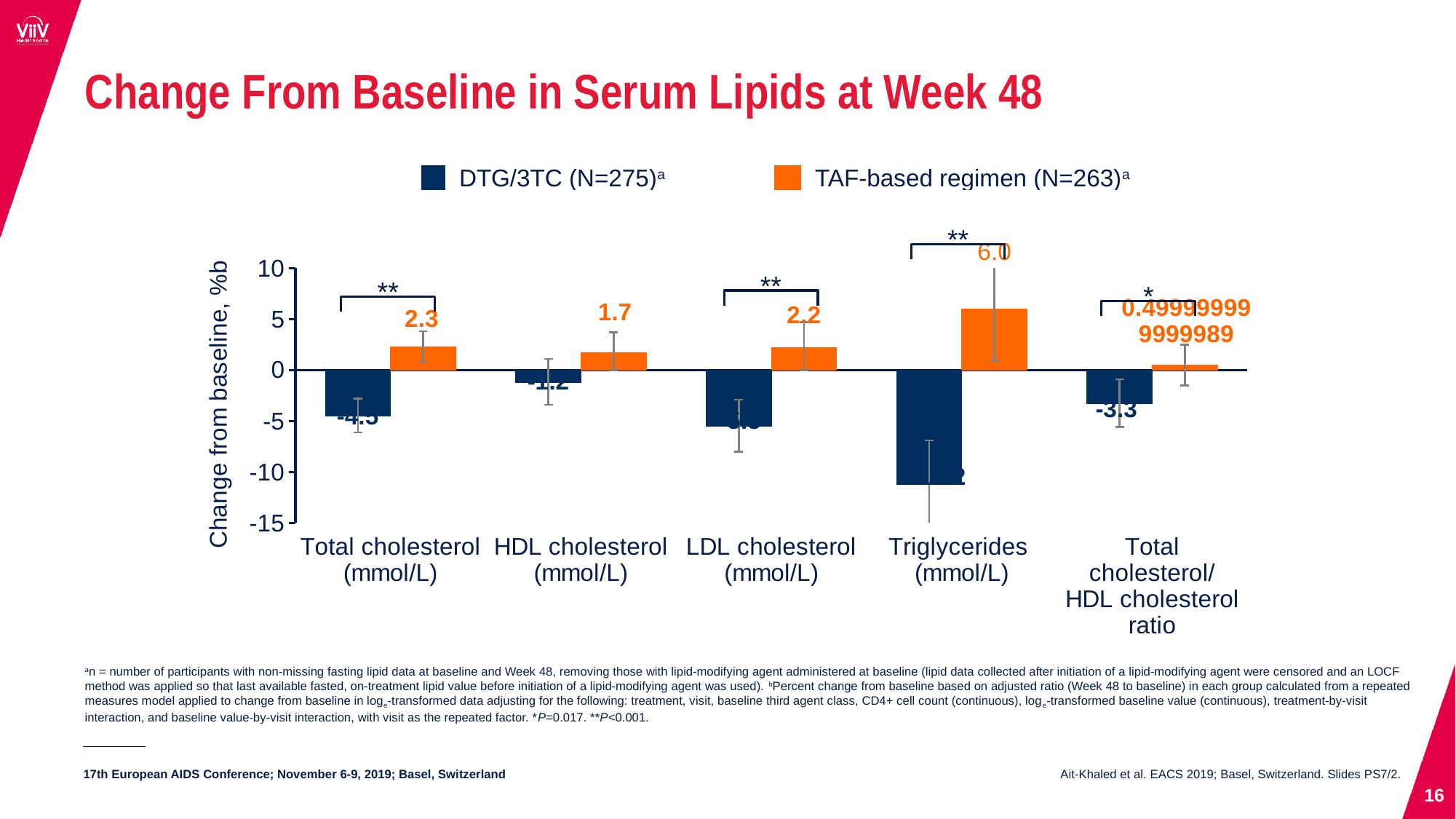
How many lipid categories are shown on the x axis? 5 What kind of chart is shown on the slide? bar chart What is the change from baseline in HDL cholesterol for DTG/3TC? -1.2 What is the change from baseline in the total cholesterol/HDL cholesterol ratio for DTG/3TC? -3.3 How many series does the legend list? 2 What is the change from baseline in HDL cholesterol for the TAF-based regimen? 1.7 What is the difference between the TAF-based regimen's change in triglycerides and its change in total cholesterol? 3.7 Is the DTG/3TC change from baseline in triglycerides greater or less than -10? less Which colour represents the TAF-based regimen in the chart? orange What is the change from baseline in triglycerides for the TAF-based regimen? 6.0 For DTG/3TC, which category has the lowest (most negative) change from baseline? Triglycerides For the TAF-based regimen, which category has the highest change from baseline? Triglycerides